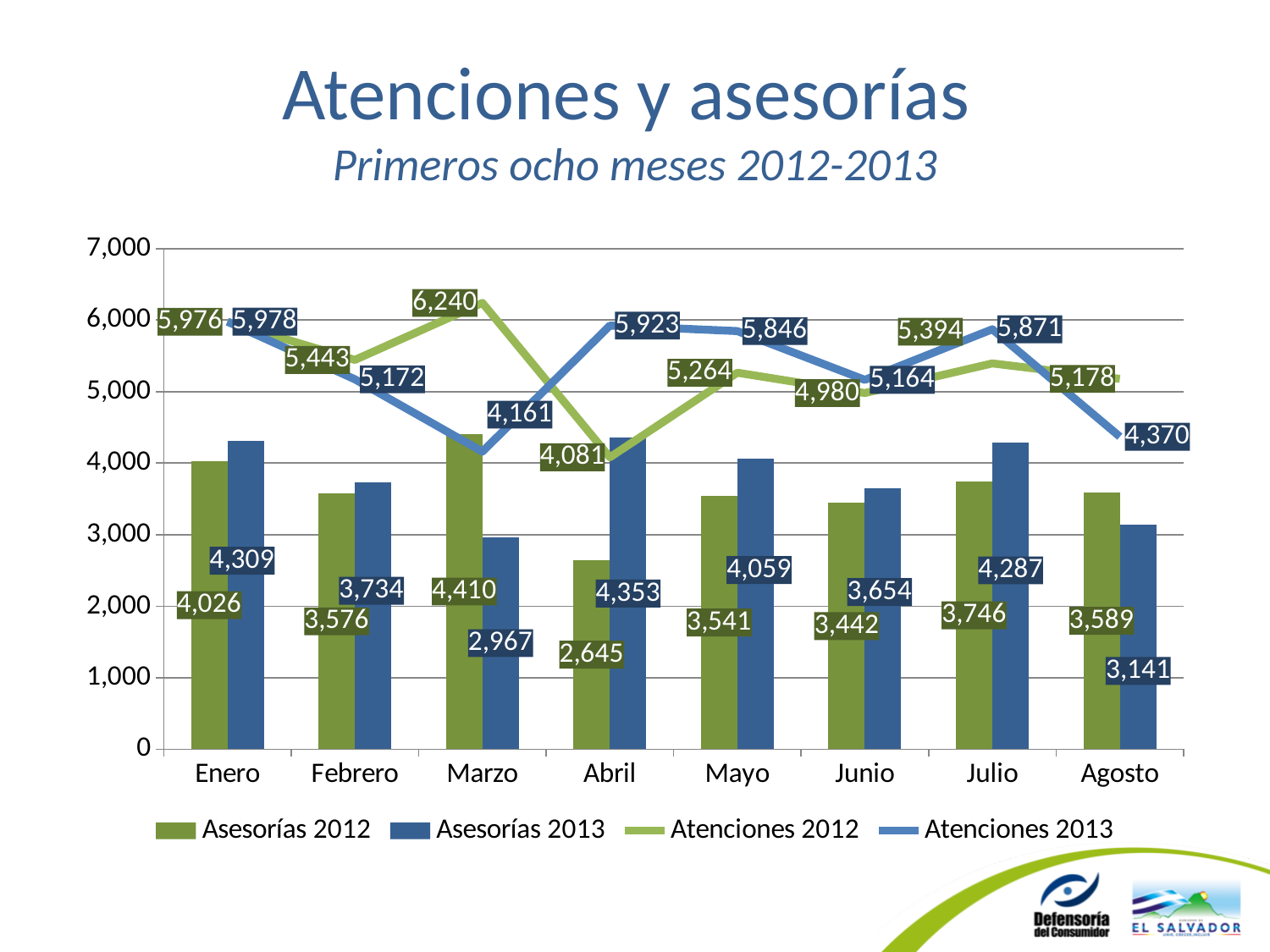
What is the value of Atenciones 2012 in Marzo? 6,240 In which month is Asesorías 2012 lowest? Abril How many months are shown on the x axis? 8 In which month is Asesorías 2013 lowest? Marzo What is the value of Asesorías 2013 in Abril? 4,353 Which is larger: Atenciones 2013 in Julio or Atenciones 2013 in Agosto? Julio What is the difference between Asesorías 2012 and Asesorías 2013 in Marzo? 1,443 What kind of chart is this? Combination bar and line chart How many series does the legend list? 4 What is the value of Atenciones 2013 in Agosto? 4,370 In which month is Atenciones 2012 highest? Marzo Does Atenciones 2013 rise or fall from Julio to Agosto? Fall